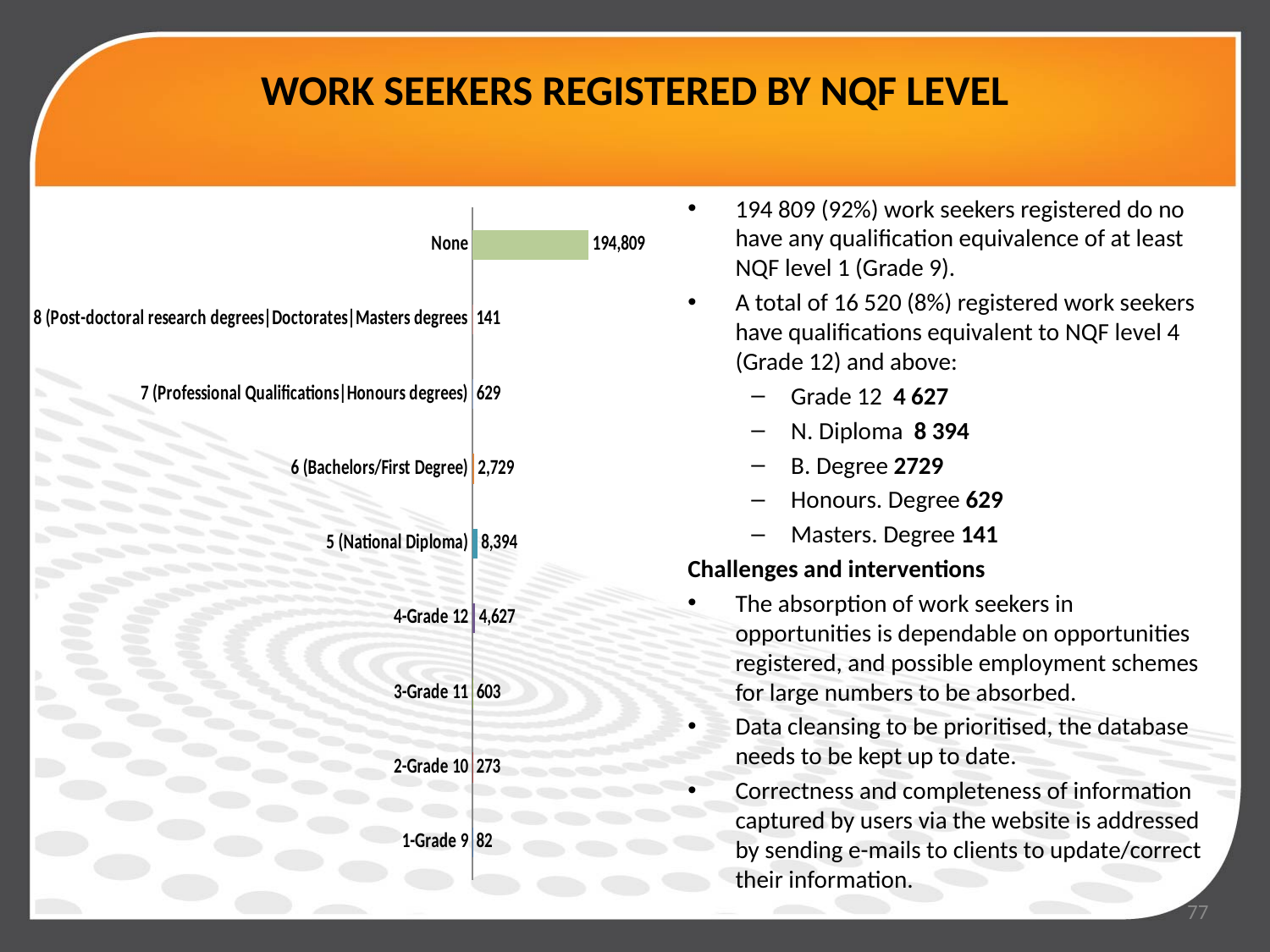
What kind of chart is shown on the slide? Bar chart What is the value for "4-Grade 12" in the chart? 4,627 What is the value for "6 (Bachelors/First Degree)" in the chart? 2,729 What is the difference between the values for "5 (National Diploma)" and "4-Grade 12"? 3,767 How many categories are shown in the chart? 9 Which category has the lowest value in the chart? 1-Grade 9 What is the difference between the values for "7 (Professional Qualifications|Honours degrees)" and "8 (Post-doctoral research degrees|Doctorates|Masters degrees)"? 488 What is the value for the "None" category in the chart? 194,809 What is the value for "1-Grade 9" in the chart? 82 What is the value for "5 (National Diploma)" in the chart? 8,394 Which category has the highest value in the chart? None Which is larger: the value for "3-Grade 11" or the value for "2-Grade 10"? 3-Grade 11